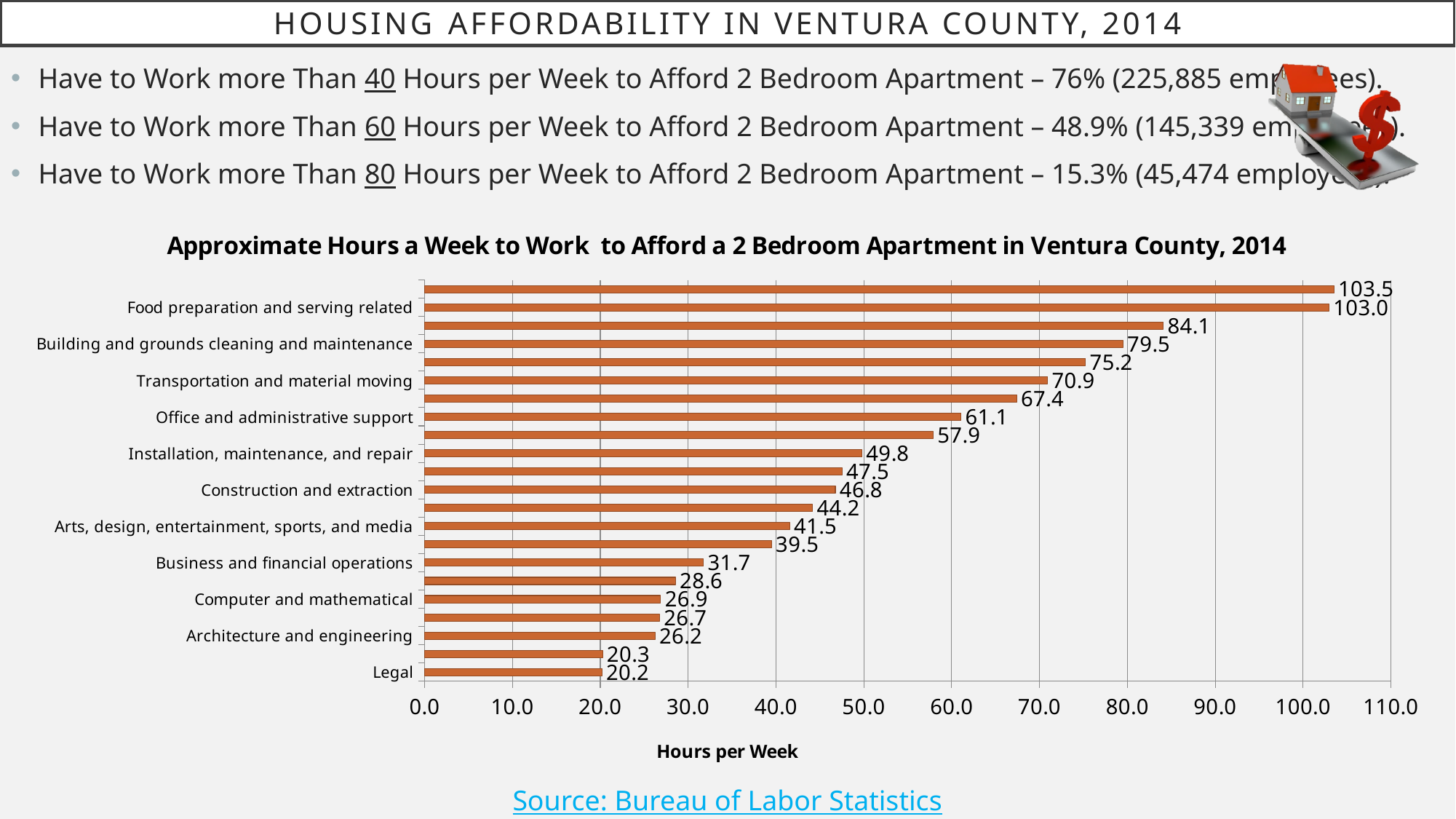
What kind of chart is shown on the slide? bar chart Is the value for Transportation and material moving greater or less than 60.0? greater How many hours per week are shown for Legal? 20.2 How many hours per week are shown for Food preparation and serving related? 103.0 What is the difference in hours per week between Food preparation and serving related and Legal? 82.8 What is the label of the horizontal axis? Hours per Week How many bars are plotted in the chart? 22 What is the title of the chart? Approximate Hours a Week to Work to Afford a 2 Bedroom Apartment in Ventura County, 2014 Which requires more hours per week: Office and administrative support or Construction and extraction? Office and administrative support What is the highest value shown in the chart? 103.5 What is the lowest value shown in the chart? 20.2 How many hours per week are shown for Office and administrative support? 61.1